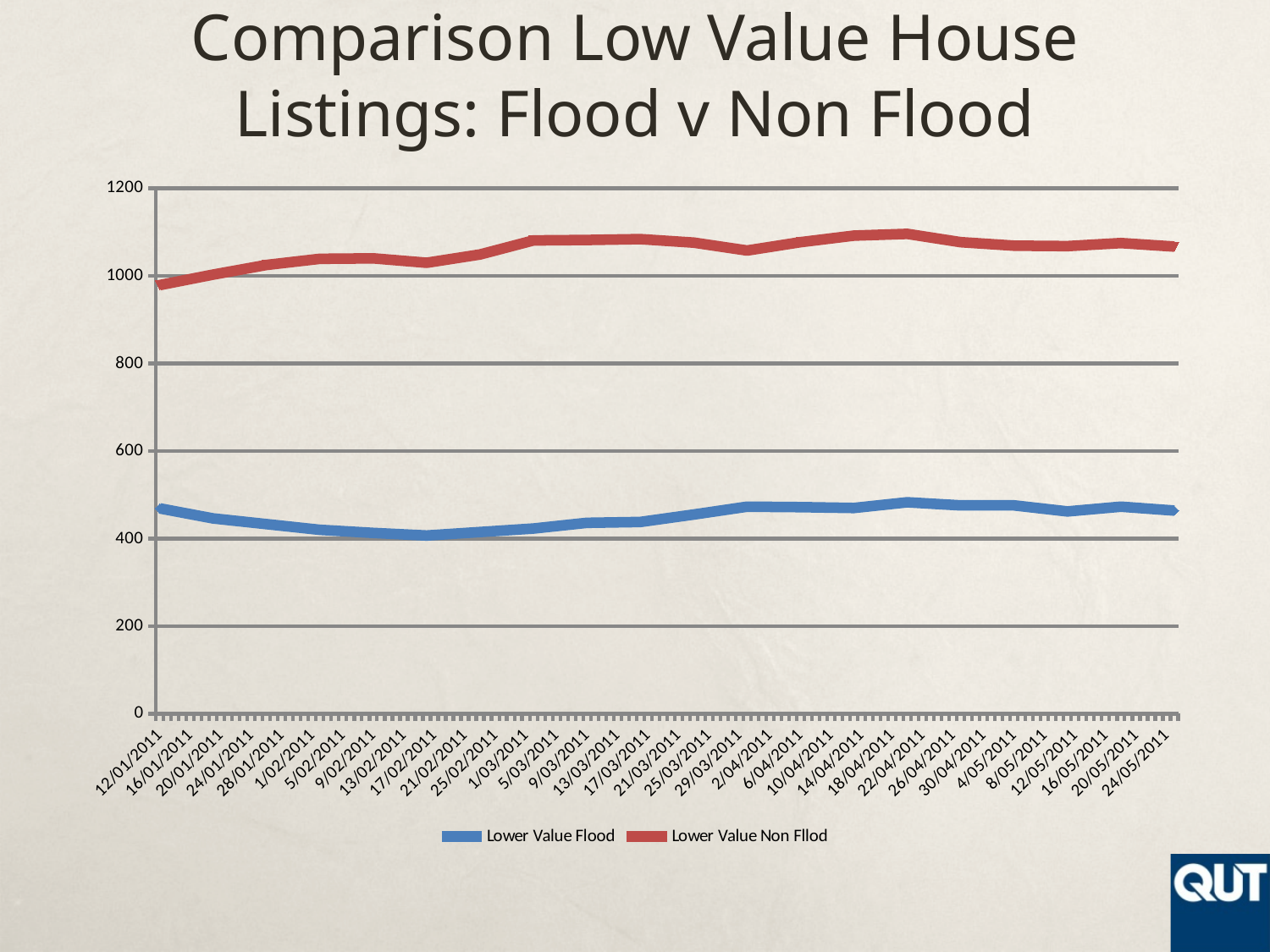
Is the value for Lower Value Flood on 12/01/2011 greater or less than 400? greater Which series is higher across the whole period shown? Lower Value Non Fllod Is the value for Lower Value Non Fllod on 12/01/2011 greater or less than 1000? less What is the title of the chart? Comparison Low Value House Listings: Flood v Non Flood Which series has the higher value on 24/05/2011, Lower Value Flood or Lower Value Non Fllod? Lower Value Non Fllod Is the value for Lower Value Non Fllod on 22/04/2011 greater or less than 1200? less What kind of chart is shown on the slide? line chart Which colour is used for the Lower Value Flood series? blue Does the Lower Value Non Fllod series rise or fall from 12/01/2011 to 1/03/2011? rise How many series does the legend list? 2